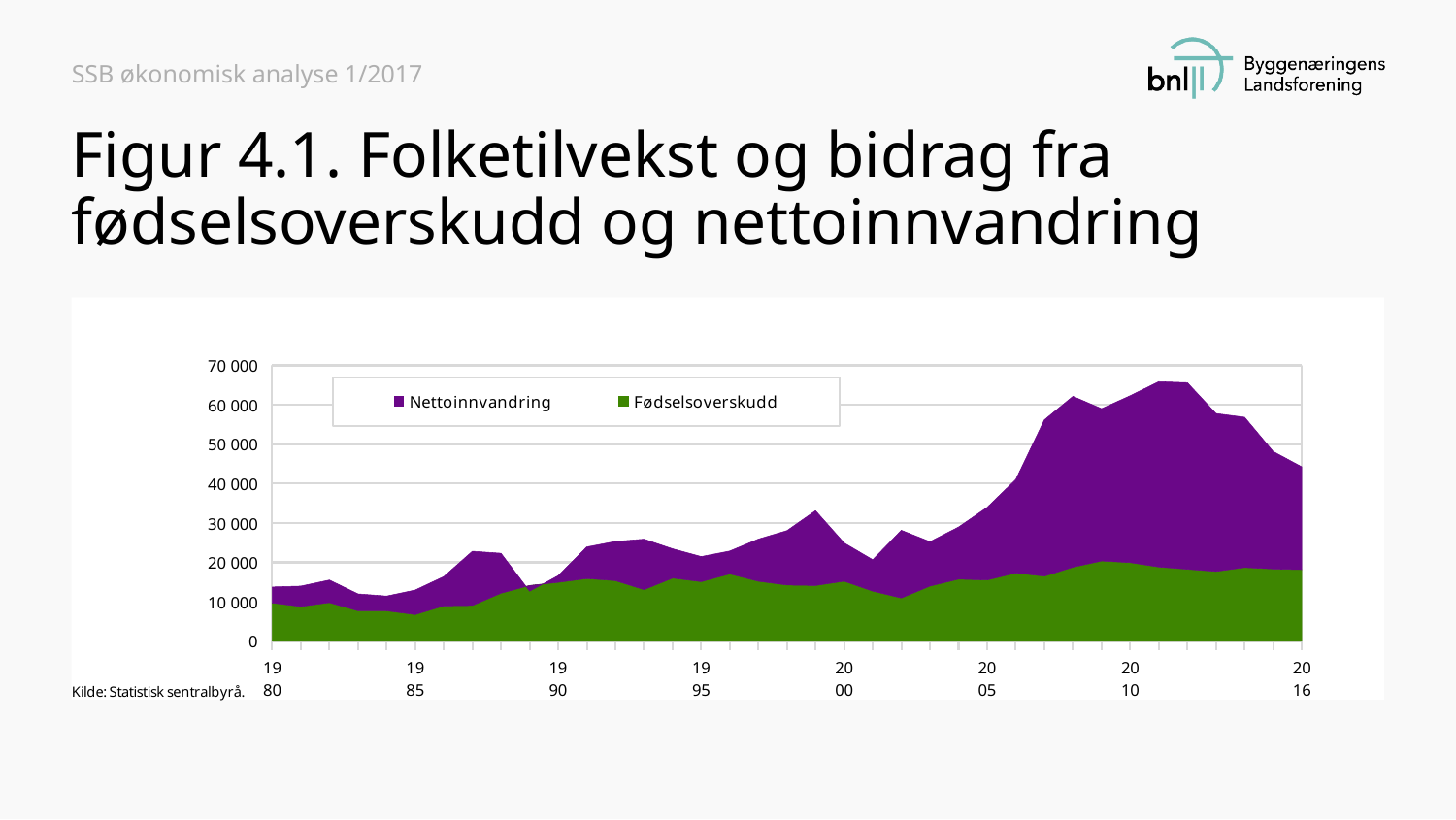
Which colour represents Fødselsoverskudd in the chart? Green How many series does the legend list? 2 Is the total value for 1980 greater or less than 20 000? less Is the Fødselsoverskudd value for 1985 greater or less than 10 000? less What kind of chart is shown on the slide? Stacked area chart Which is larger, the total value in 2016 or the total value in 1980? 2016 Does the total value rise or fall between 2005 and 2010? Rise Does the total value rise or fall between 2012 and 2016? Fall Which two series are listed in the legend? Nettoinnvandring and Fødselsoverskudd What is the highest value shown on the y axis? 70 000 Is the total value (Nettoinnvandring plus Fødselsoverskudd) for 2016 greater or less than 40 000? greater